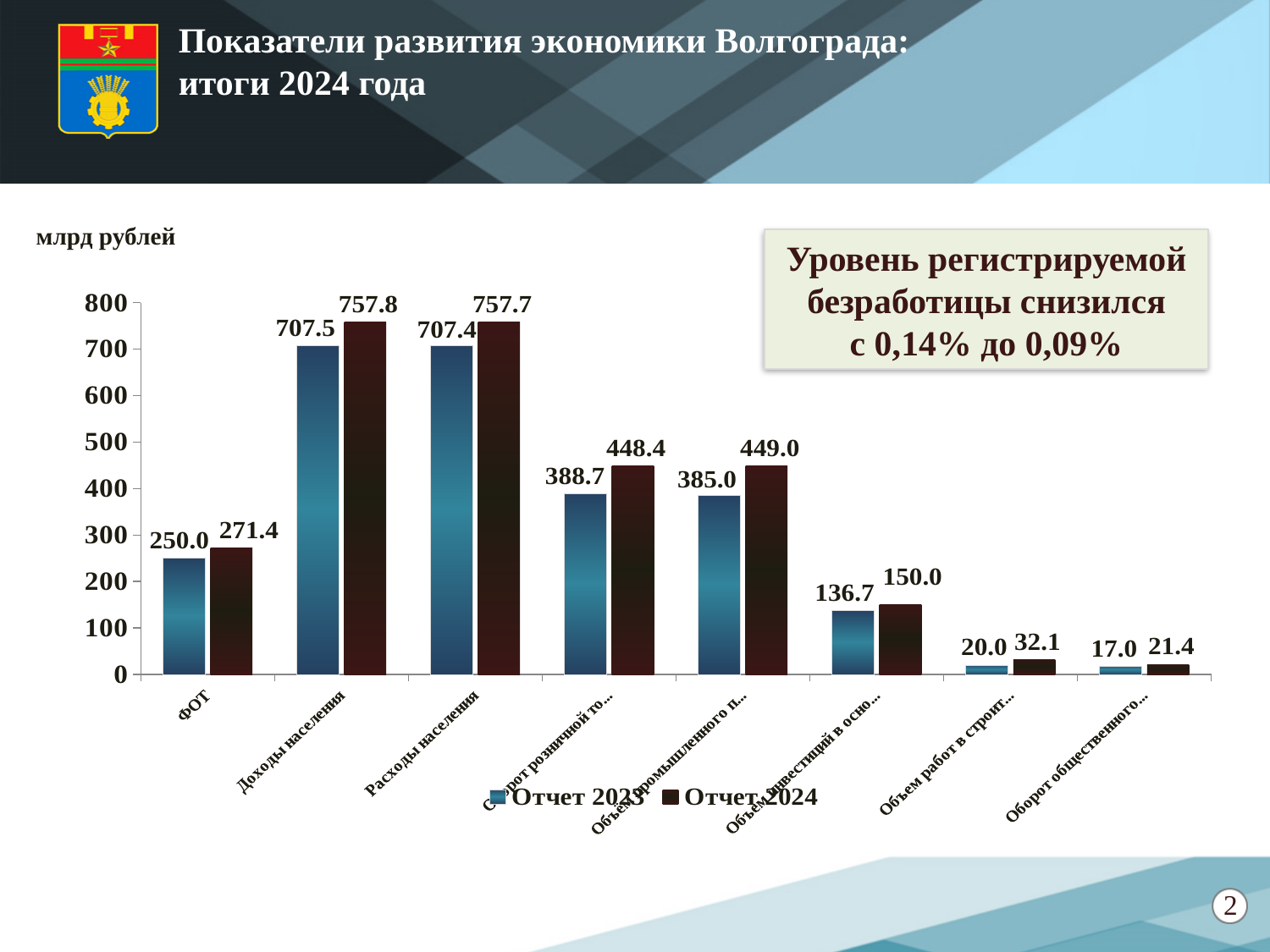
What unit label is shown above the chart? млрд рублей What is the value for Доходы населения in the Отчет 2024 series? 757.8 What is the value for ФОТ in the Отчет 2023 series? 250.0 Which is larger for Расходы населения: the Отчет 2023 value or the Отчет 2024 value? Отчет 2024 Is the Отчет 2023 value for Доходы населения greater or less than 600? greater How many categories are shown on the x axis of the chart? 8 What is the value for Расходы населения in the Отчет 2023 series? 707.4 What kind of chart is shown on the slide? bar chart How many series does the chart legend list? 2 What is the value for ФОТ in the Отчет 2024 series? 271.4 What is the difference between the Отчет 2024 and Отчет 2023 values for ФОТ? 21.4 What is the difference between the Отчет 2024 and Отчет 2023 values for Доходы населения? 50.3